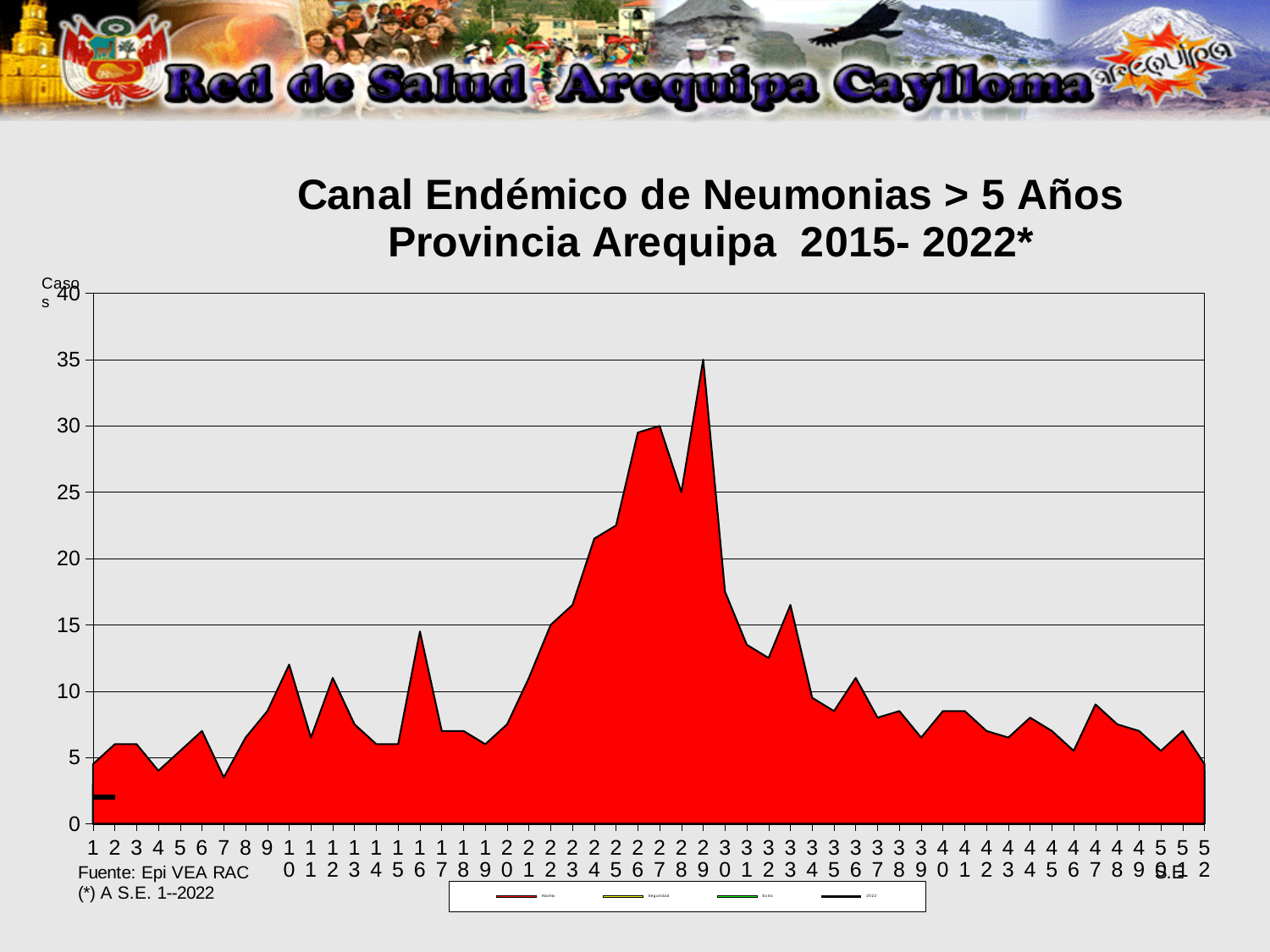
Is the value at week 26 greater or less than 25? greater Is the value at week 29 greater or less than 30? greater Do the values rise or fall from week 20 to week 29? rise Is the value at week 40 greater or less than 10? less What is the title of the chart? Canal Endémico de Neumonias > 5 Años Provincia Arequipa 2015- 2022* What kind of chart is shown on the slide? area chart At which week does the red area reach its highest point? 29 Which week has the larger value, week 33 or week 36? week 33 What is the highest value shown on the vertical axis of the chart? 40 How many epidemiological weeks are plotted along the x axis? 52 Which week has the larger value, week 26 or week 29? week 29